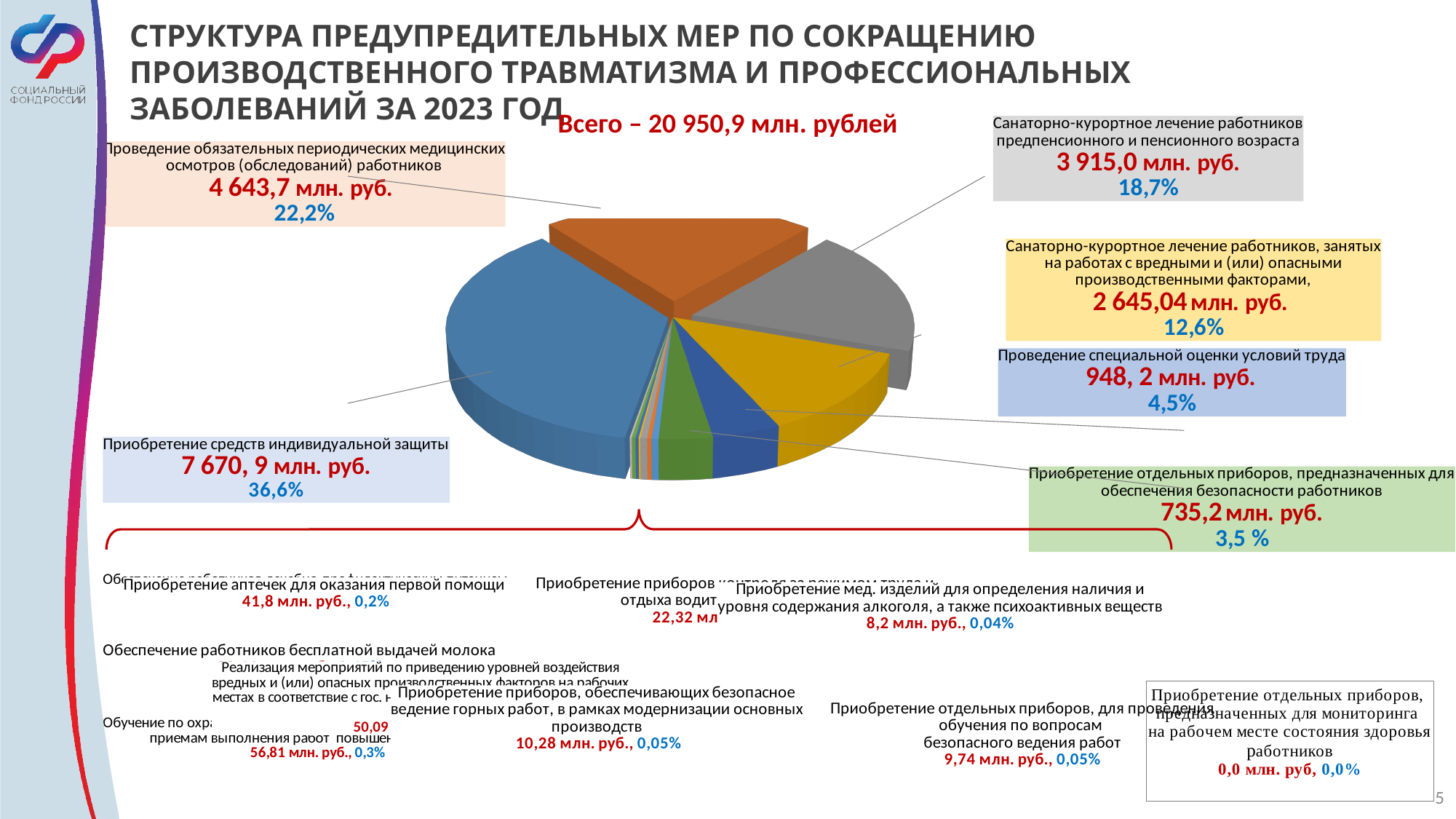
What is the value for Приобретение средств индивидуальной защиты? 7 670, 9 млн. руб. What share of the pie does Приобретение мед. изделий для определения наличия и уровня содержания алкоголя, а также психоактивных веществ have? 0,04% What is the difference in млн. руб. between Проведение обязательных периодических медицинских осмотров (обследований) работников and Санаторно-курортное лечение работников предпенсионного и пенсионного возраста? 728,7 млн. руб. What is the value for Санаторно-курортное лечение работников предпенсионного и пенсионного возраста? 3 915,0 млн. руб. Which category has the largest share of the pie? Приобретение средств индивидуальной защиты What share of the pie does Проведение специальной оценки условий труда have? 4,5% Which is larger: Санаторно-курортное лечение работников, занятых на работах с вредными и (или) опасными производственными факторами, or Проведение специальной оценки условий труда? Санаторно-курортное лечение работников, занятых на работах с вредными и (или) опасными производственными факторами What kind of chart is shown on the slide? Pie chart What is the total amount shown above the pie chart (Всего)? 20 950,9 млн. рублей What is the value for Приобретение аптечек для оказания первой помощи? 41,8 млн. руб. What share of the pie does Проведение обязательных периодических медицинских осмотров (обследований) работников have? 22,2% What is the value for Приобретение отдельных приборов, предназначенных для обеспечения безопасности работников? 735,2 млн. руб.